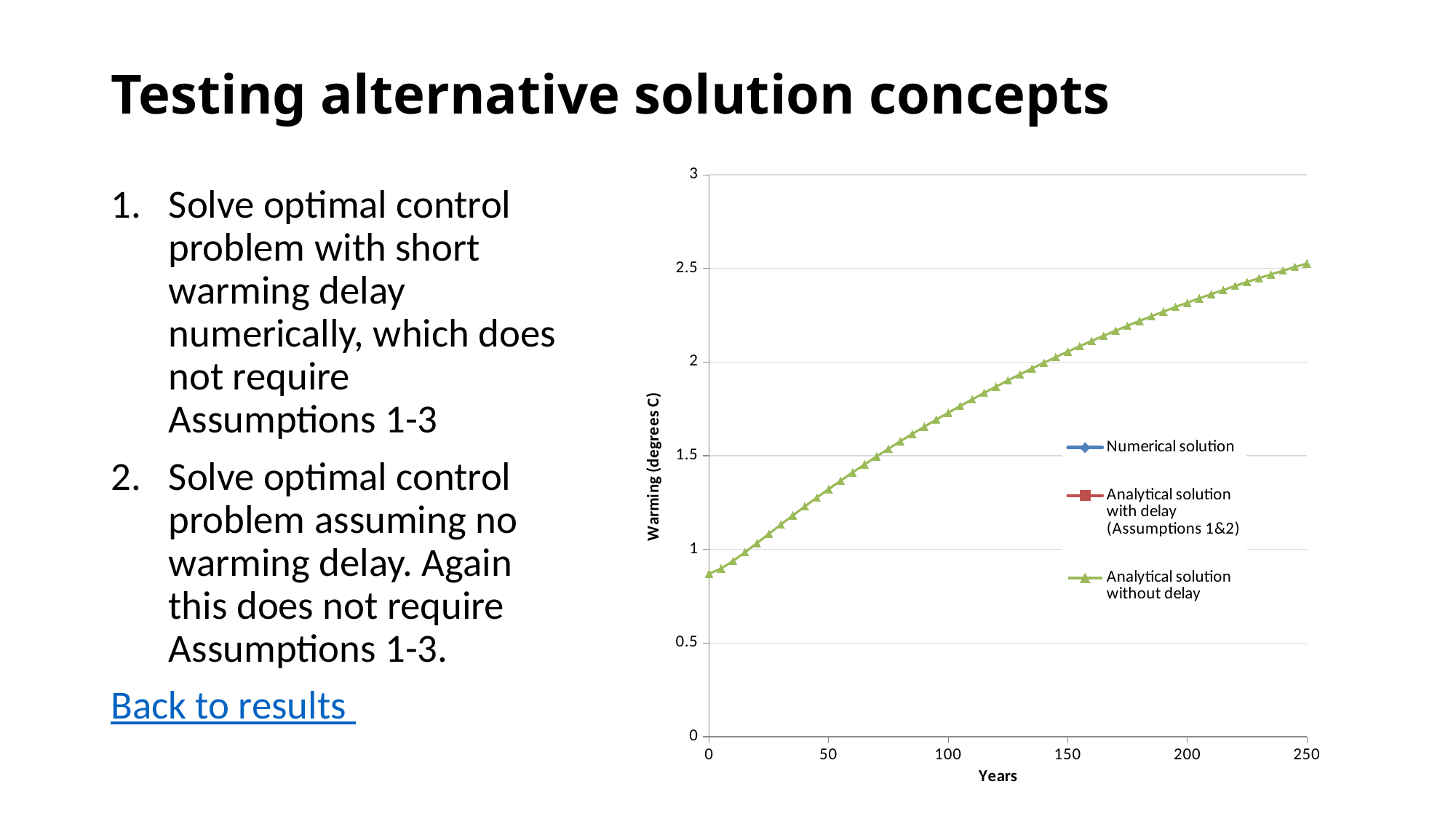
What is the label of the chart's x axis? Years What kind of chart is shown on the slide? line chart Is the warming value at year 50 greater or less than 1.5? less Is the warming value at year 100 greater or less than 1.5? greater Is the warming value at year 200 greater or less than 2? greater How many series does the chart's legend list? 3 Do the plotted warming values rise or fall as the years increase along the x axis? rise What is the label of the chart's y axis? Warming (degrees C)